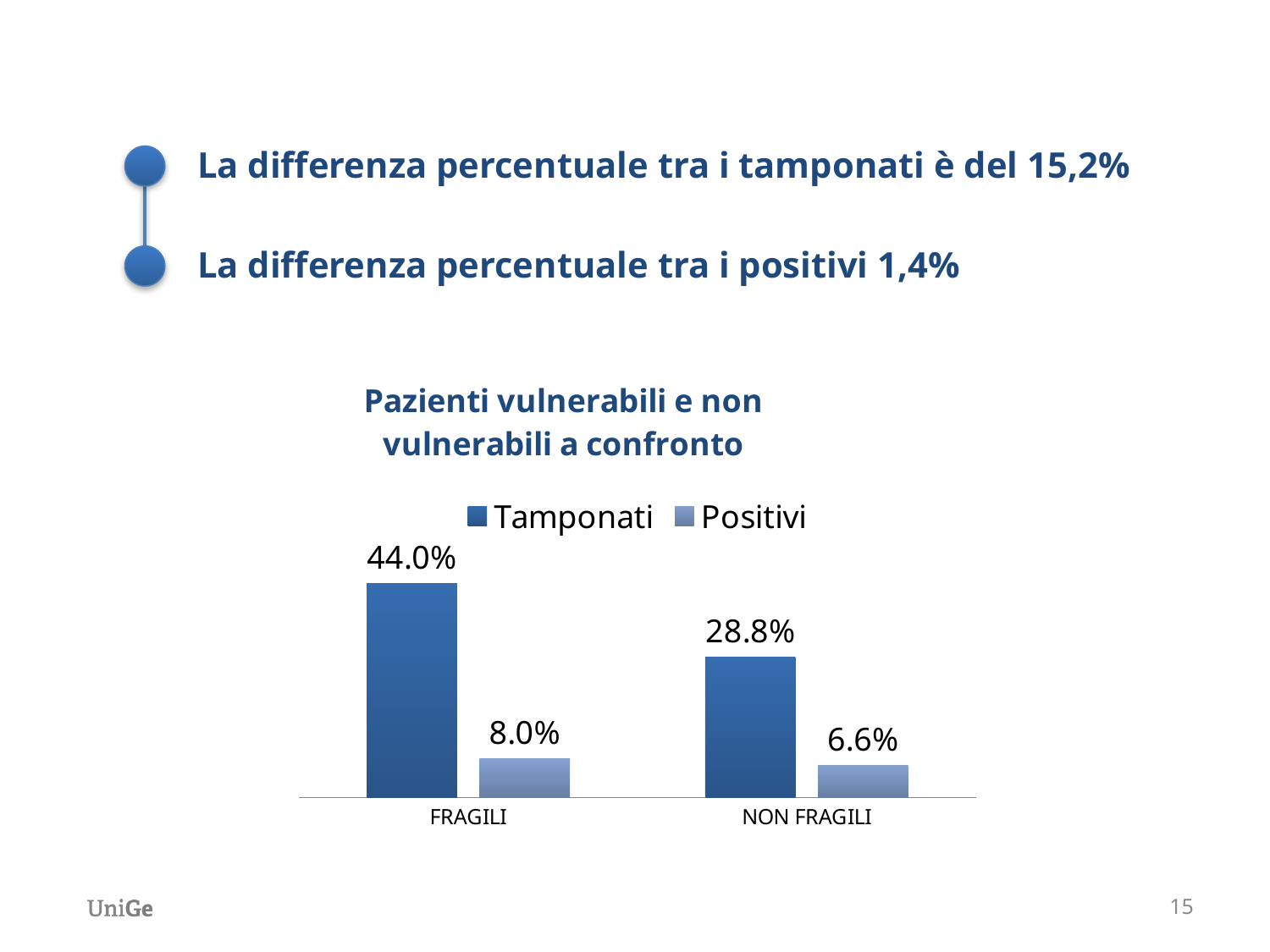
What is the Tamponati value for NON FRAGILI? 28.8% What kind of chart is shown on the slide? Bar chart How many series does the legend list? 2 What is the Positivi value for NON FRAGILI? 6.6% What is the Tamponati value for FRAGILI? 44.0% Which category has the highest Tamponati value? FRAGILI Which is larger: the Positivi value for FRAGILI or the Positivi value for NON FRAGILI? FRAGILI What is the difference between the Tamponati values for FRAGILI and NON FRAGILI? 15.2% Which category has the lowest Positivi value? NON FRAGILI What is the difference between the Positivi values for FRAGILI and NON FRAGILI? 1.4% How many categories are shown on the x axis? 2 What is the Positivi value for FRAGILI? 8.0%